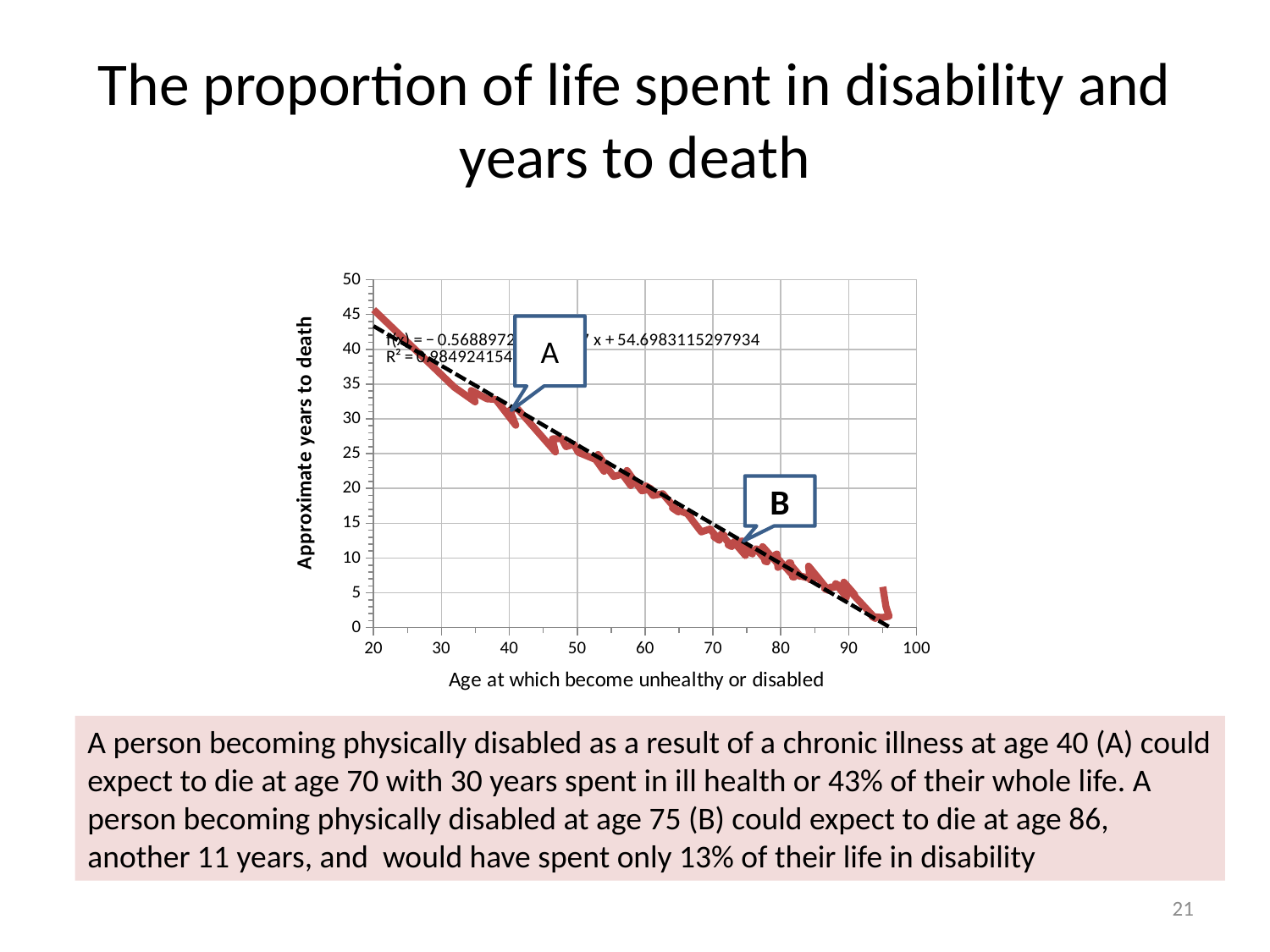
What is the difference in years to death between point A (age 40) and point B (age 75)? 19 years Which point has more years to death, A (age 40) or B (age 75)? A Do the approximate years to death rise or fall as the age at which one becomes unhealthy or disabled increases? fall What is the label of the x axis? Age at which become unhealthy or disabled According to the slide, how many years to death does a person becoming disabled at age 40 (point A) have? 30 years Is the value for age 85 greater or less than 10? less Is the value for age 20 greater or less than 40? greater According to the slide, how many years to death does a person becoming disabled at age 75 (point B) have? 11 years What kind of chart is shown on the slide? line chart What is the label of the y axis? Approximate years to death Is the value for age 45 greater or less than 25? greater